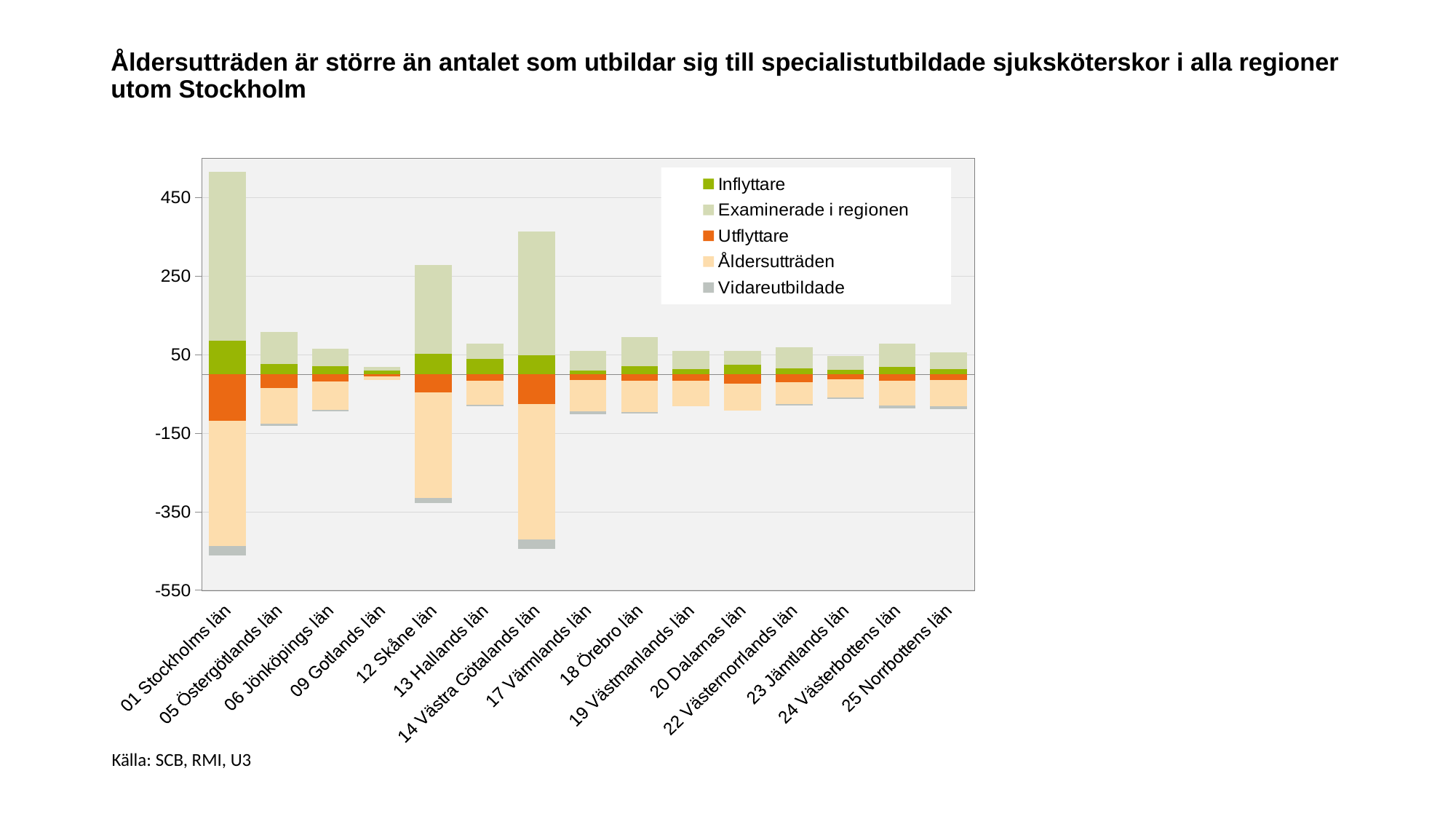
Which region has the larger positive stacked bar, 12 Skåne län or 14 Västra Götalands län? 14 Västra Götalands län What kind of chart is shown on the slide? Stacked bar chart Which region has the tallest positive stacked bar? 01 Stockholms län Is the bottom of the negative stacked bar for 05 Östergötlands län greater or less than -150? greater How many regions (categories) are shown on the x axis? 15 Is the top of the positive stacked bar for 01 Stockholms län greater or less than 450? greater Is the bottom of the negative stacked bar for 01 Stockholms län greater or less than -350? less Which legend entry is listed last? Vidareutbildade How many series does the legend list? 5 Which series is shown in orange in the legend? Utflyttare